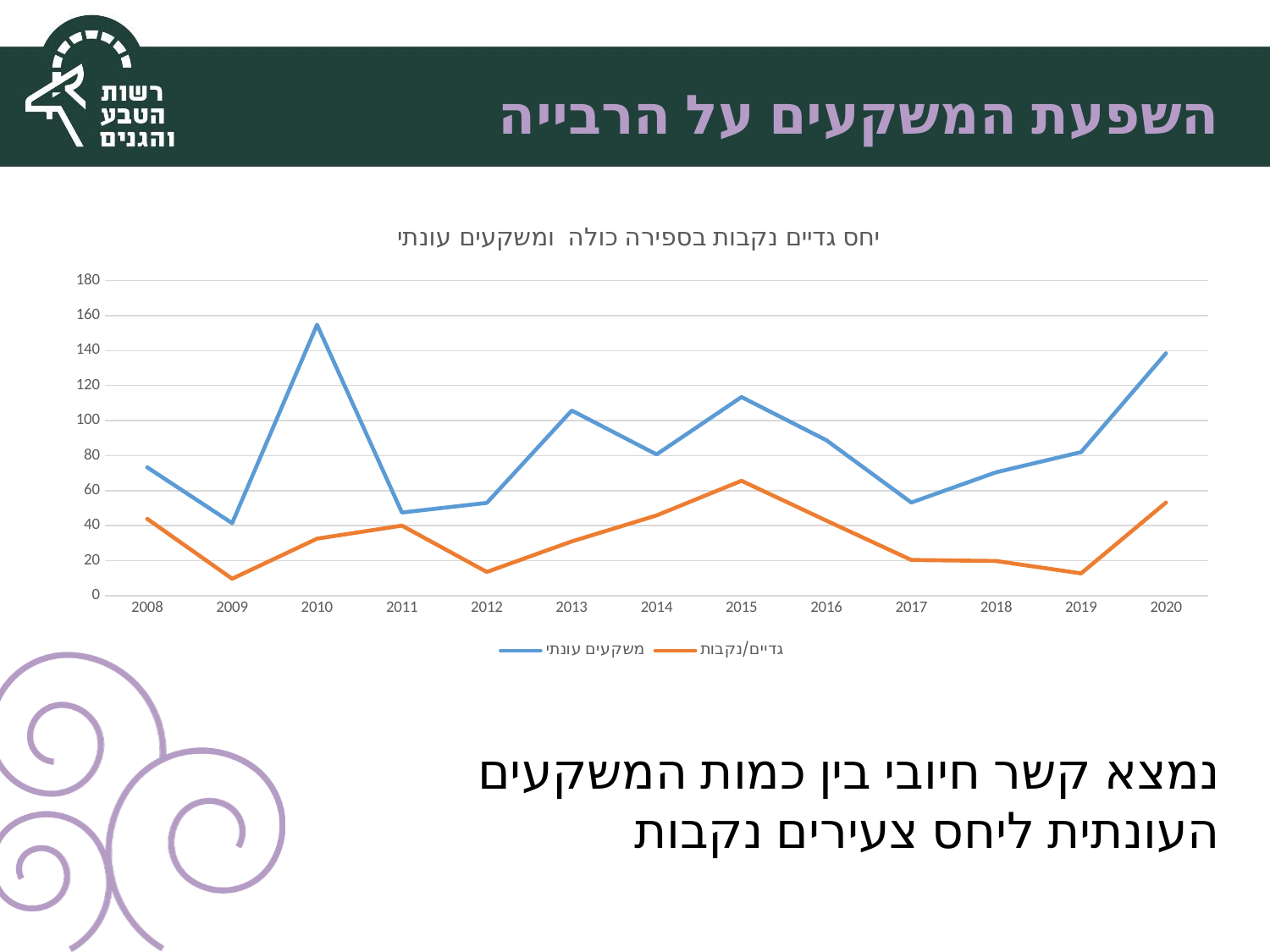
In which year does the משקעים עונתי series reach its highest value? 2010 In which year does the משקעים עונתי series reach its lowest value? 2009 Is the value for גדיים/נקבות in 2015 greater or less than 60? greater What kind of chart is shown on the slide? line chart In which year does the גדיים/נקבות series reach its highest value? 2015 Is the value for גדיים/נקבות in 2012 greater or less than 20? less Which is larger for משקעים עונתי: the value in 2010 or the value in 2020? 2010 How many series does the legend list? 2 Is the value for משקעים עונתי in 2010 greater or less than 140? greater What is the title of the chart? יחס גדיים נקבות בספירה כולה ומשקעים עונתי How many years are plotted along the x axis? 13 Does the משקעים עונתי series rise or fall from 2017 to 2020? rise